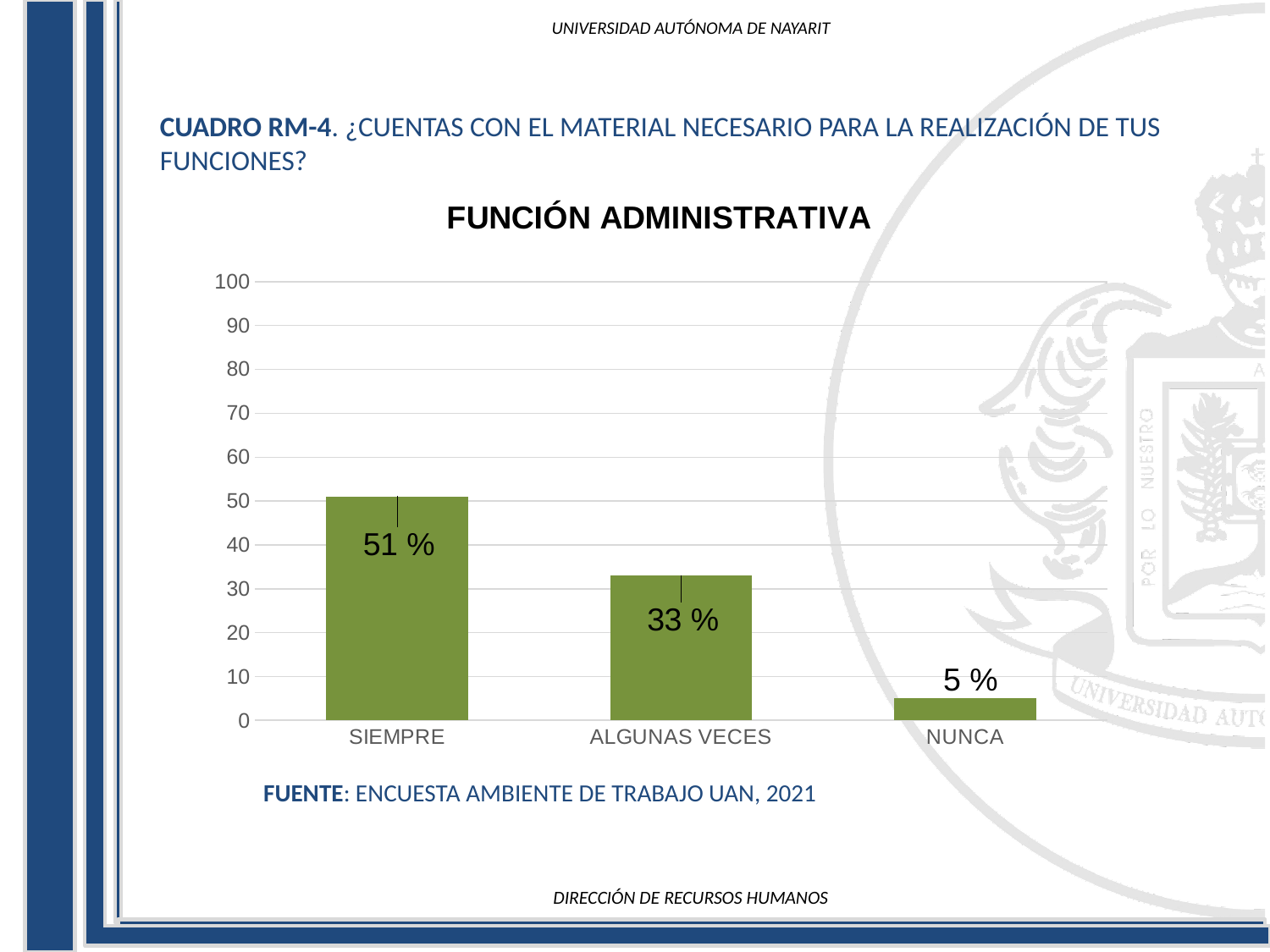
Which category has the lowest value? NUNCA What is the title of the chart? FUNCIÓN ADMINISTRATIVA What is the value for NUNCA? 5 % What kind of chart is shown on the slide? bar chart What is the difference between the values for ALGUNAS VECES and NUNCA? 28 % What is the value for SIEMPRE? 51 % Is the value for SIEMPRE greater or less than 40? greater Which category has the highest value? SIEMPRE What is the difference between the values for SIEMPRE and ALGUNAS VECES? 18 % What is the value for ALGUNAS VECES? 33 % How many categories are shown on the x axis? 3 Which is larger, the value for ALGUNAS VECES or the value for NUNCA? ALGUNAS VECES